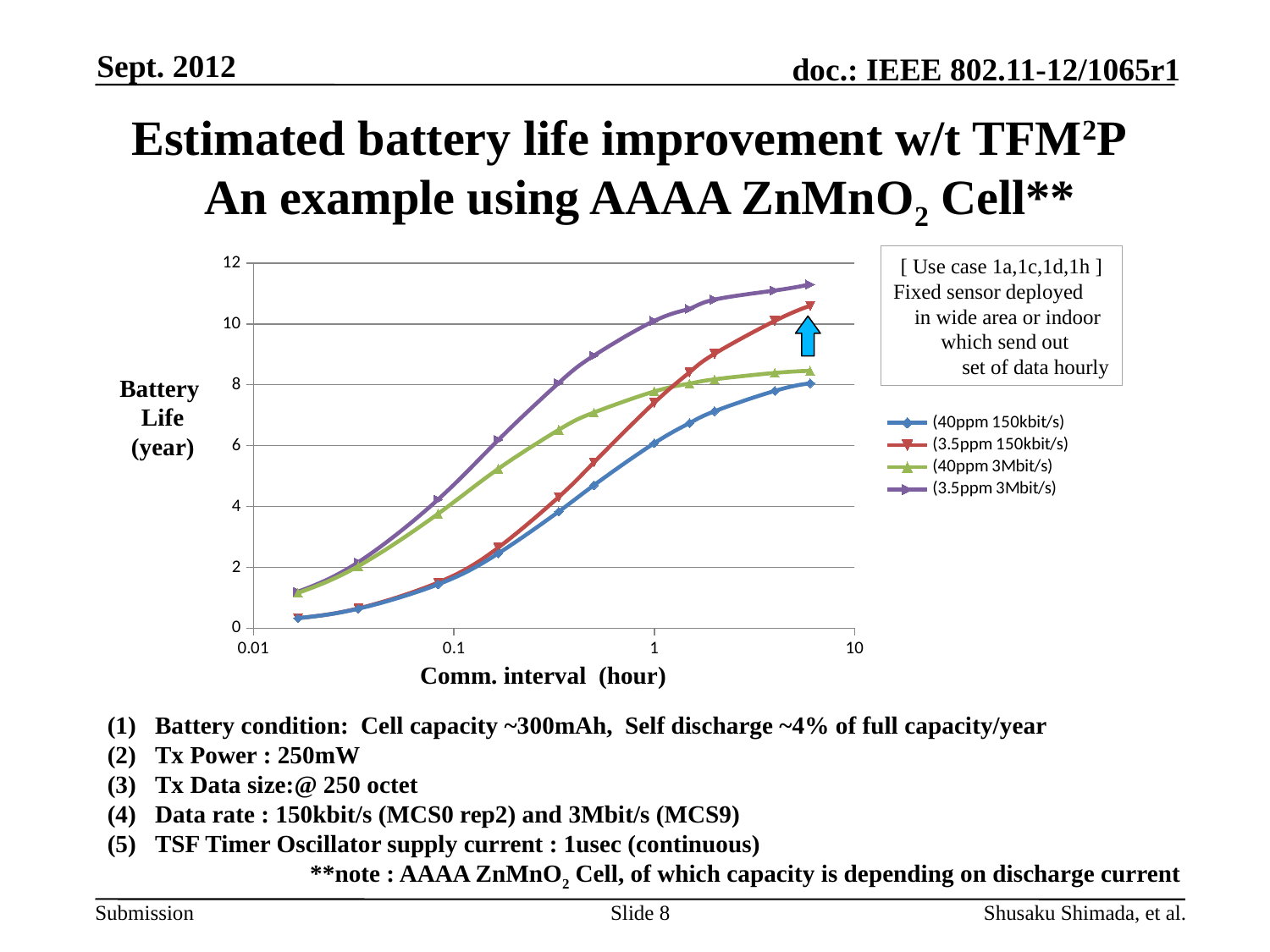
How many series does the chart legend list? 4 At a communication interval of 0.1 hour, which series has the higher battery life: (40ppm 3Mbit/s) or (40ppm 150kbit/s)? (40ppm 3Mbit/s) What is the label of the chart's y axis? Battery Life (year) Which series has the highest battery life at the largest communication interval plotted? (3.5ppm 3Mbit/s) Do the battery life values rise or fall as the communication interval increases along the x axis? rise Is the battery life for (40ppm 150kbit/s) at a communication interval of 0.1 hour greater or less than 2 years? less At a communication interval of 1 hour, which series has the higher battery life: (3.5ppm 3Mbit/s) or (40ppm 150kbit/s)? (3.5ppm 3Mbit/s) What is the label of the chart's x axis? Comm. interval (hour) Is the battery life for (3.5ppm 3Mbit/s) at the largest communication interval plotted greater or less than 10 years? greater Is the battery life for (40ppm 3Mbit/s) at the largest communication interval plotted greater or less than 10 years? less What kind of chart is shown on the slide? line chart